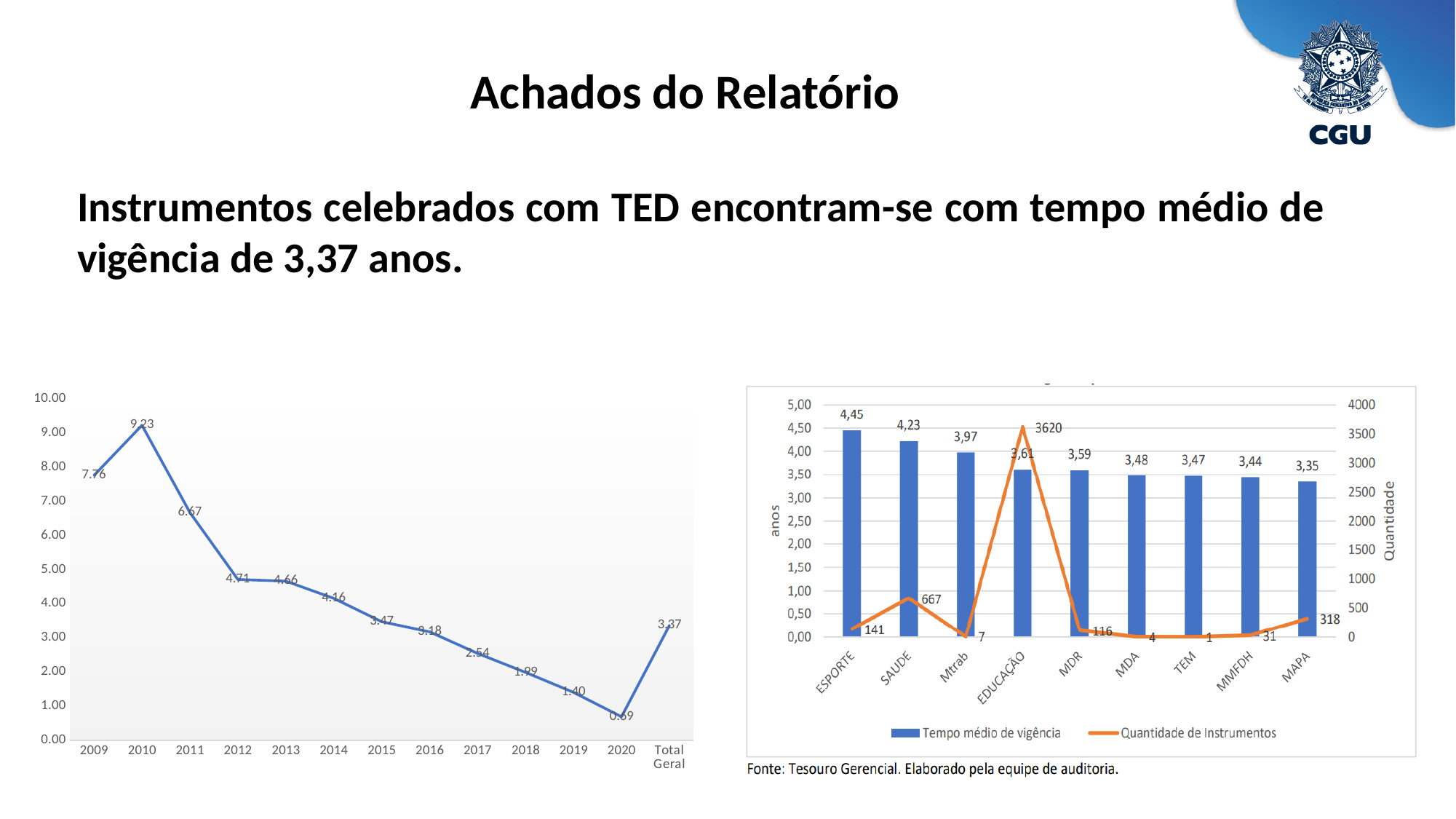
In the line chart on the left, what is the value for Total Geral? 3.37 In the chart on the right, what is the Quantidade de Instrumentos for SAUDE? 667 In the line chart on the left, what is the difference between the values for 2009 and 2011? 1.09 In the line chart on the left, which year has the lowest value? 2020 In the chart on the right, which category has the highest Quantidade de Instrumentos? EDUCAÇÃO In the line chart on the left, how many points are plotted, including Total Geral? 13 In the chart on the right, what is the difference in Quantidade de Instrumentos between EDUCAÇÃO and MAPA? 3302 In the line chart on the left, do the values rise or fall from 2010 to 2020? fall In the chart on the right, which is larger, the Tempo médio de vigência for SAUDE or for MAPA? SAUDE In the line chart on the left, what is the value for 2010? 9.23 In the chart on the right, how many series does the legend list? 2 In the chart on the right, what is the Tempo médio de vigência for ESPORTE? 4,45